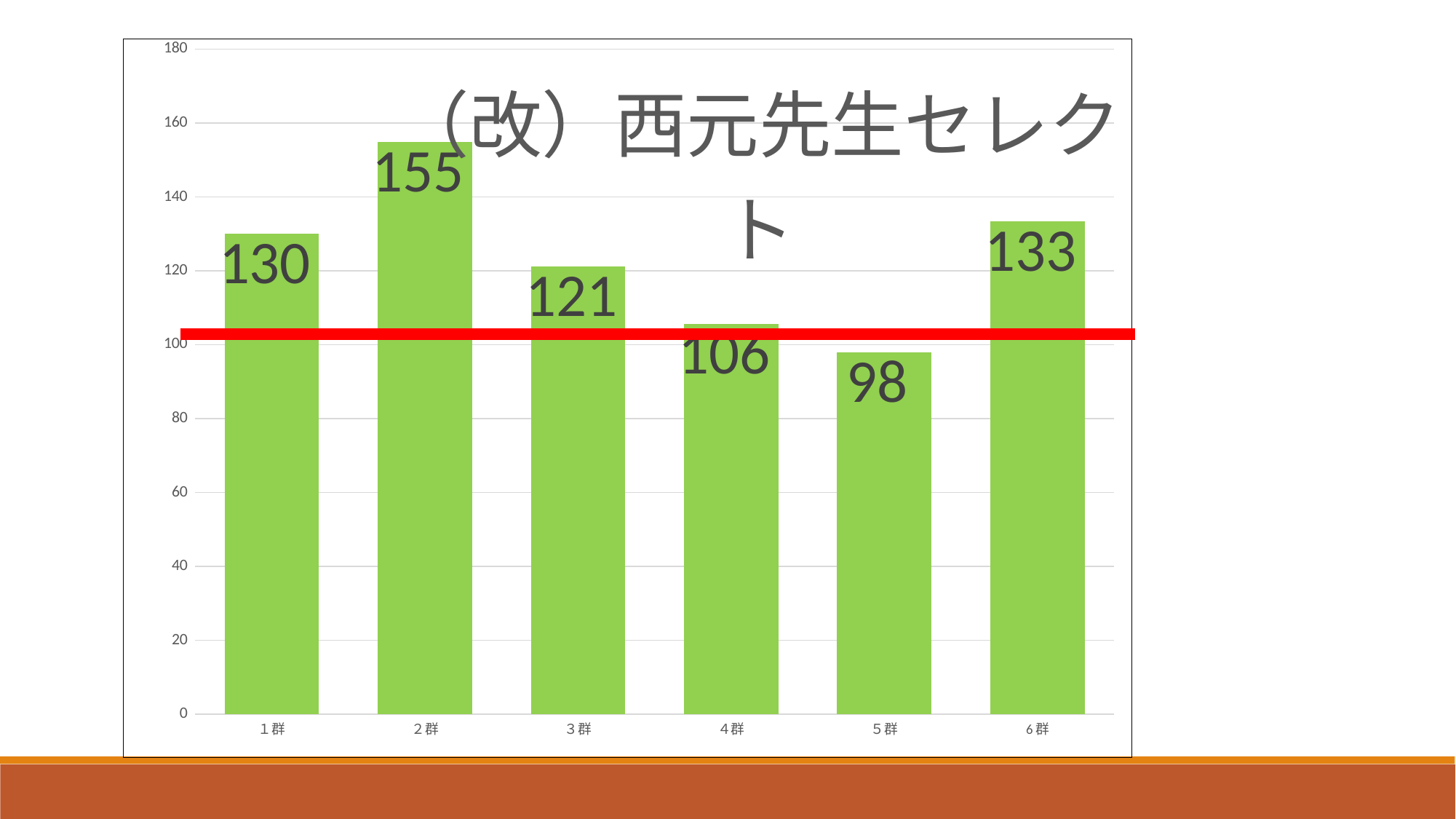
What is the value for 5群? 98 Is the value for 5群 greater or less than 100? less What is the title of the chart? （改）西元先生セレクト What is the value for 2群? 155 How many categories are shown on the x axis? 6 What is the difference between the values for 2群 and 5群? 57 Which category has the highest value? 2群 Which is larger, the value for 1群 or the value for 3群? 1群 Which category has the lowest value? 5群 What is the difference between the values for 6群 and 1群? 3 What is the value for 4群? 106 What kind of chart is shown on the slide? bar chart